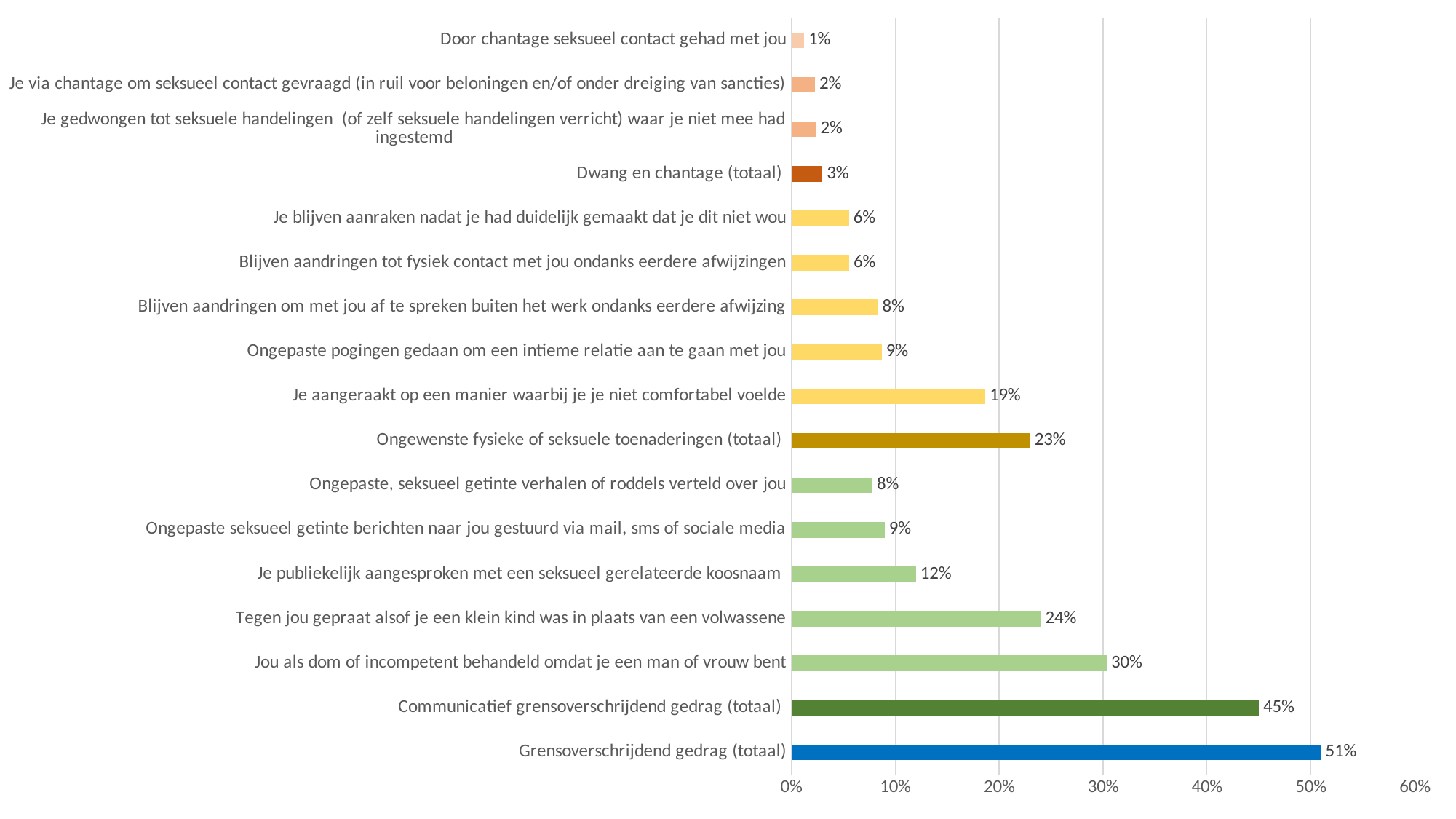
What is the difference between "Grensoverschrijdend gedrag (totaal)" and "Communicatief grensoverschrijdend gedrag (totaal)"? 6% What is the value for "Ongewenste fysieke of seksuele toenaderingen (totaal)"? 23% What is the value for "Tegen jou gepraat alsof je een klein kind was in plaats van een volwassene"? 24% Which is larger: "Jou als dom of incompetent behandeld omdat je een man of vrouw bent" or "Je aangeraakt op een manier waarbij je je niet comfortabel voelde"? Jou als dom of incompetent behandeld omdat je een man of vrouw bent What is the value for "Dwang en chantage (totaal)"? 3% What is the value for "Grensoverschrijdend gedrag (totaal)"? 51% Which category has the lowest value? Door chantage seksueel contact gehad met jou What kind of chart is this? Bar chart What is the value for "Communicatief grensoverschrijdend gedrag (totaal)"? 45% Is the value for "Je publiekelijk aangesproken met een seksueel gerelateerde koosnaam" greater or less than 10%? greater Which category has the highest value? Grensoverschrijdend gedrag (totaal) How many categories are shown in the chart? 17